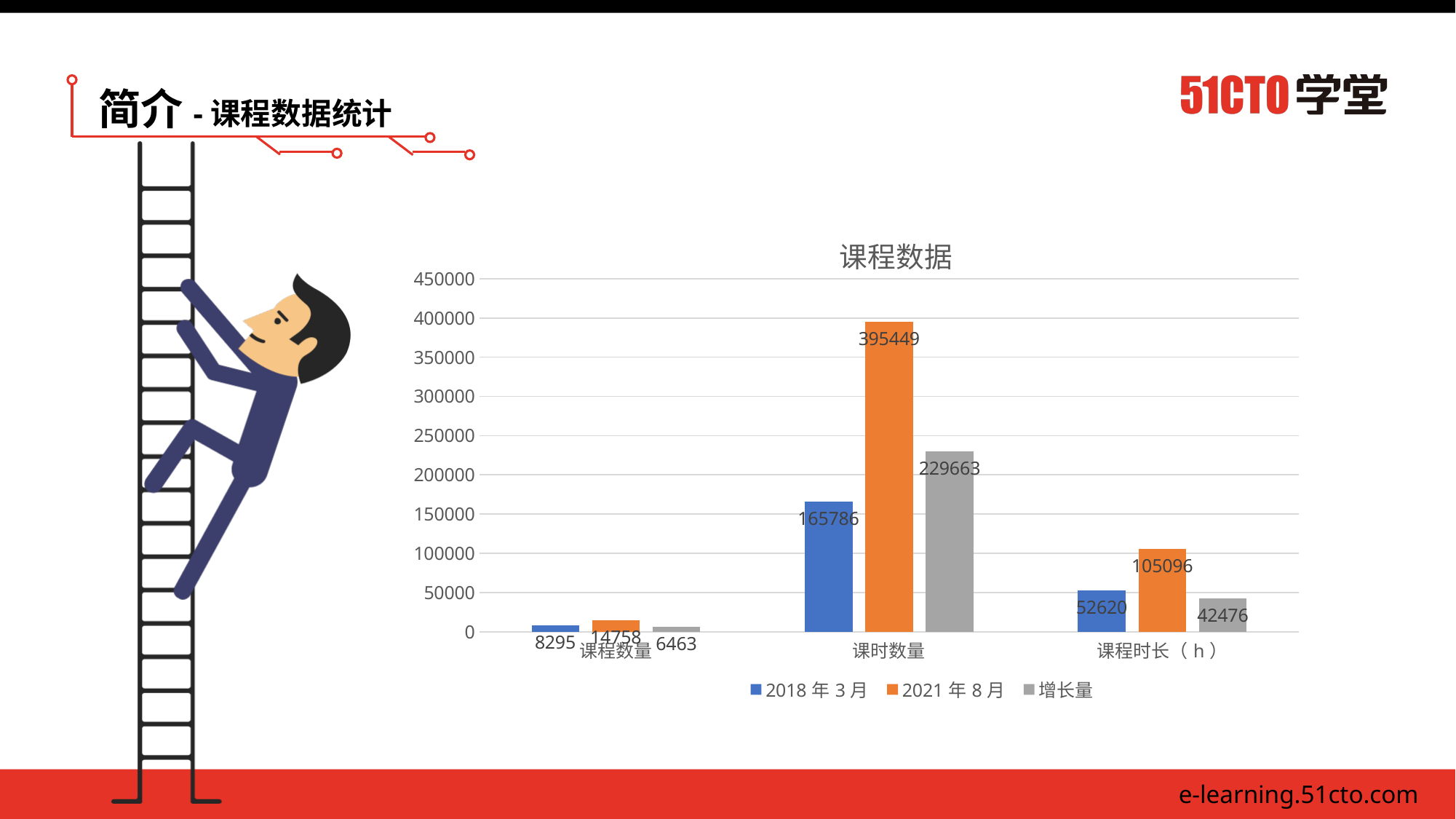
How many series does the legend list? 3 Is the 2021 年 8 月 value for 课时数量 greater or less than 350000? greater What is the value for 2018 年 3 月 in the 课程时长（h） category? 52620 Which category has the highest value for 2021 年 8 月? 课时数量 What is the value for 2021 年 8 月 in the 课程数量 category? 14758 What is the 增长量 value for 课程数量? 6463 What is the difference between the 2021 年 8 月 and 2018 年 3 月 values for 课程时长（h）? 52476 Which is larger for 课时数量: the 增长量 value or the 2018 年 3 月 value? 增长量 What type of chart is shown on the slide? bar chart Which category has the lowest value for 2018 年 3 月? 课程数量 What is the value for 2021 年 8 月 in the 课时数量 category? 395449 How many categories are shown on the x axis? 3